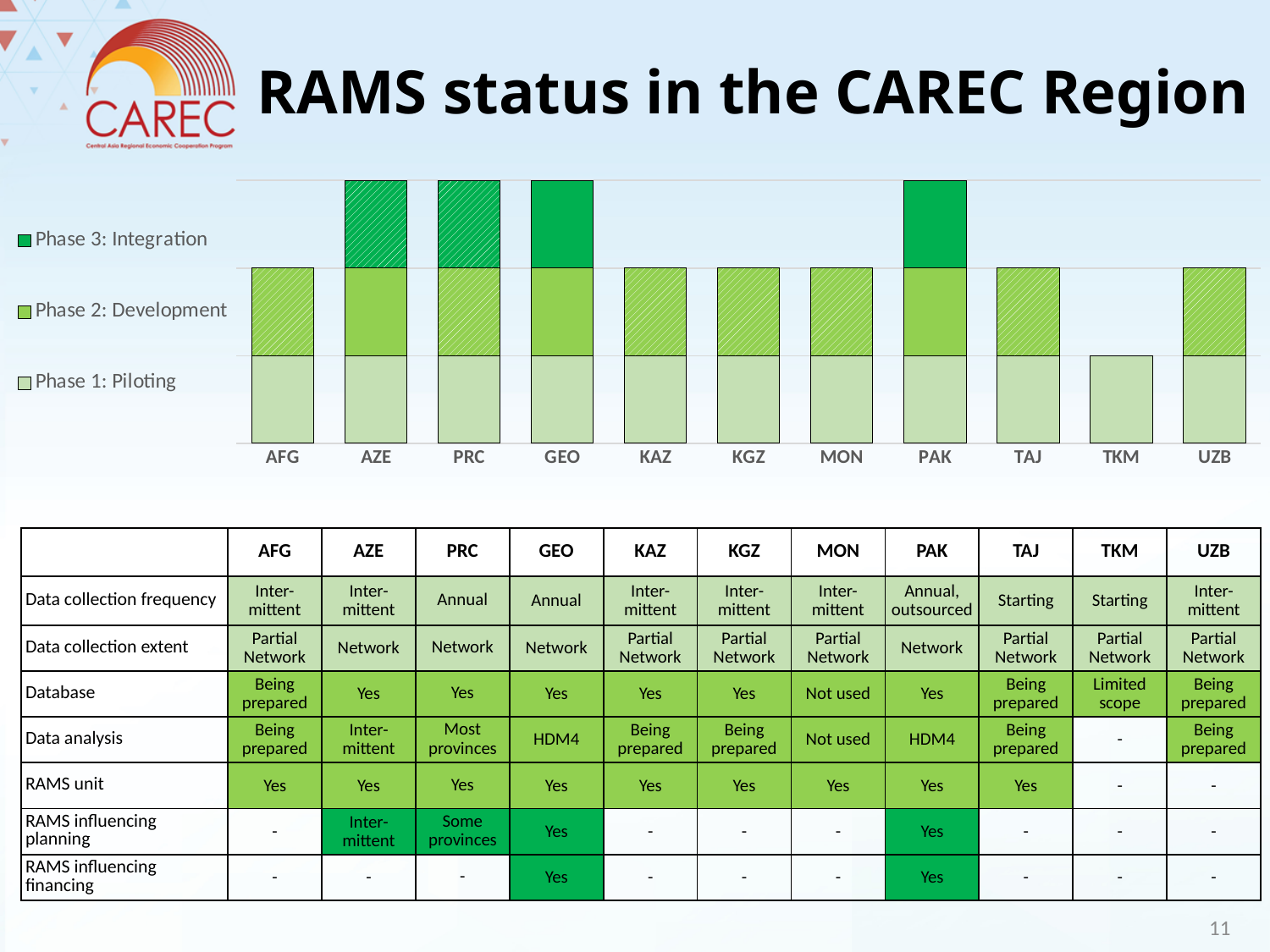
What kind of chart is shown on the slide? Stacked bar chart How many countries are shown on the x axis of the chart? 11 Which country's bar in the chart consists only of the Phase 1: Piloting segment? TKM Which is taller in the chart, the bar for GEO or the bar for KAZ? GEO Which is taller in the chart, the bar for PAK or the bar for TAJ? PAK Which is taller in the chart, the bar for AFG or the bar for TKM? AFG Which country has the lowest bar in the chart? TKM Which countries' bars in the chart include the Phase 3: Integration segment? AZE, PRC, GEO, PAK What is the label of the bottom series in the chart's legend? Phase 1: Piloting How many series does the chart's legend list? 3